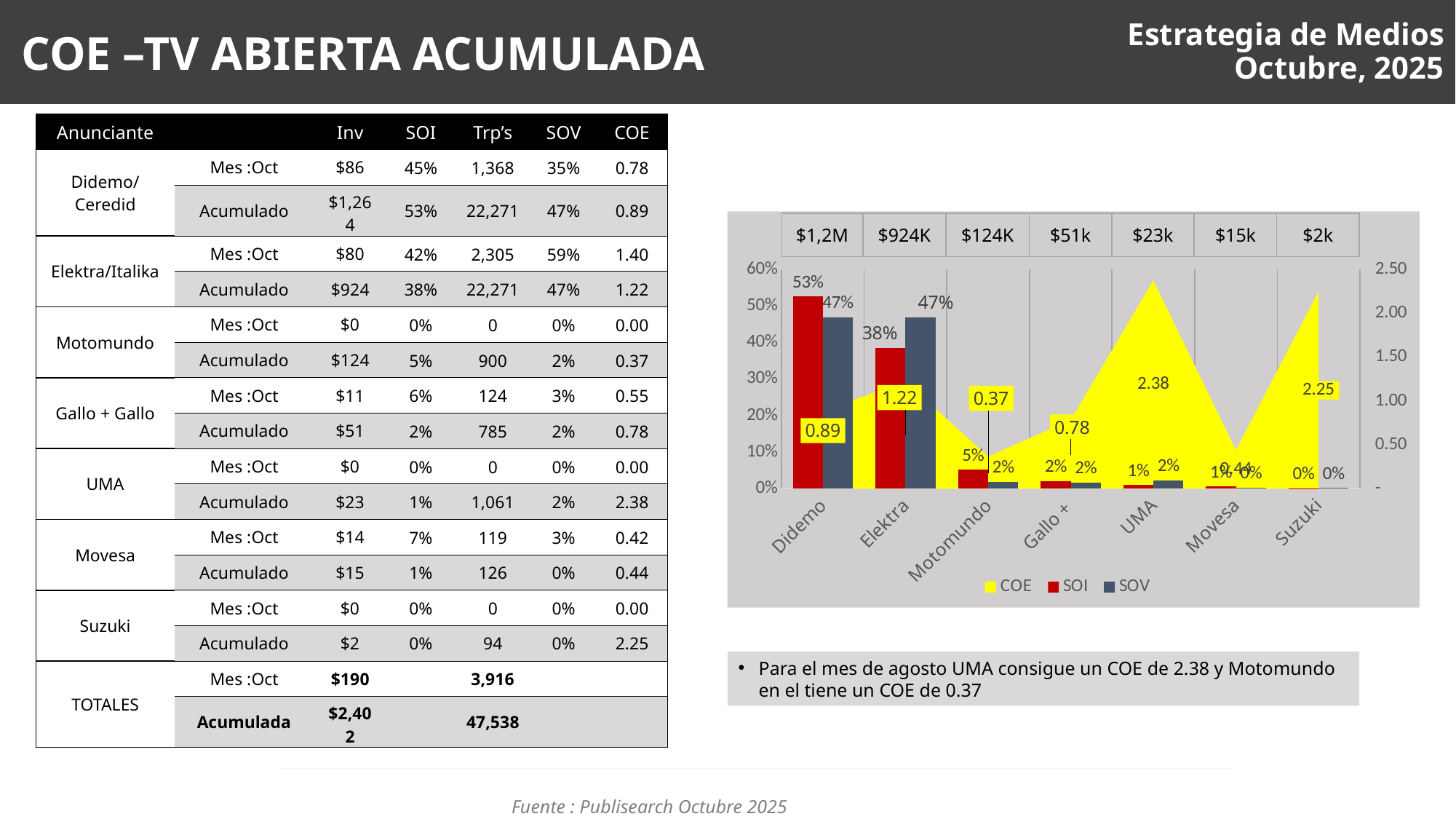
What is the SOV value for Elektra in the chart? 47% Which series in the chart is shown in yellow? COE What is the difference between the SOI values for Didemo and Elektra? 15% What is the difference between the COE values for UMA and Suzuki? 0.13 Which category has the highest SOI value in the chart? Didemo How many categories are shown on the x axis of the chart? 7 Which category has the highest COE value in the chart? UMA What COE value is labelled for UMA in the chart? 2.38 How many series does the chart legend list? 3 What is the SOI value for Didemo in the chart? 53% Which is larger, the COE for Elektra or the COE for Gallo +? Elektra What COE value is labelled for Motomundo in the chart? 0.37